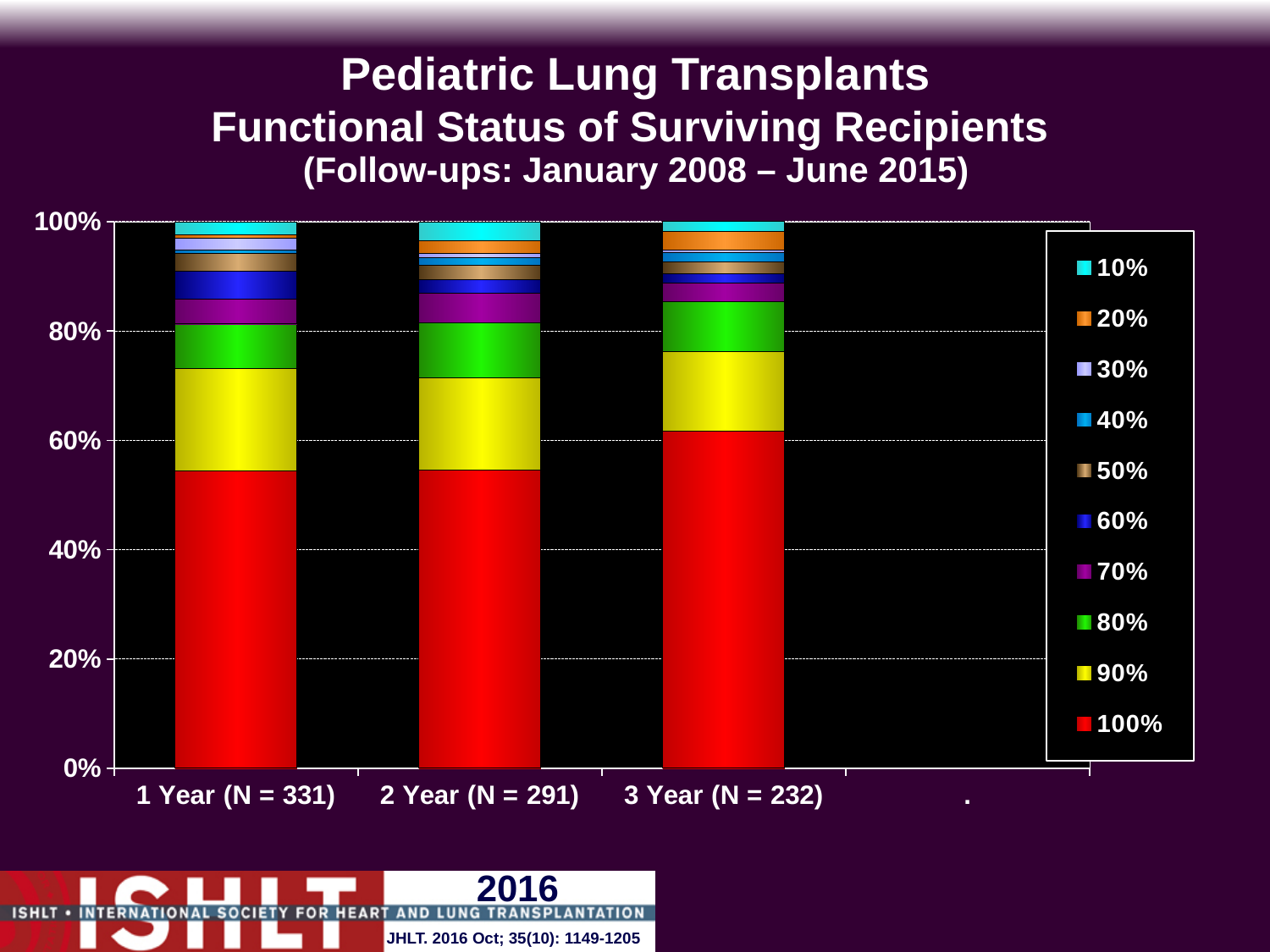
Does the share of the 100% functional status segment rise or fall from 1 Year to 3 Year? rise Is the 100% functional status segment larger for 1 Year (N = 331) or for 3 Year (N = 232)? 3 Year (N = 232) How many series does the legend list? 10 What is the N shown for the 3 Year category? 232 How many follow-up categories are plotted on the x axis? 3 Is the share of the 100% functional status segment for 2 Year (N = 291) greater or less than 60%? less Which follow-up category has the largest 100% functional status segment? 3 Year (N = 232) What colour represents the 100% series in the legend? Red What kind of chart is shown on the slide? Stacked bar chart What is the N shown for the 2 Year category? 291 Is the share of the 100% functional status segment for 1 Year (N = 331) greater or less than 60%? less What follow-up period is given in the chart title? January 2008 – June 2015